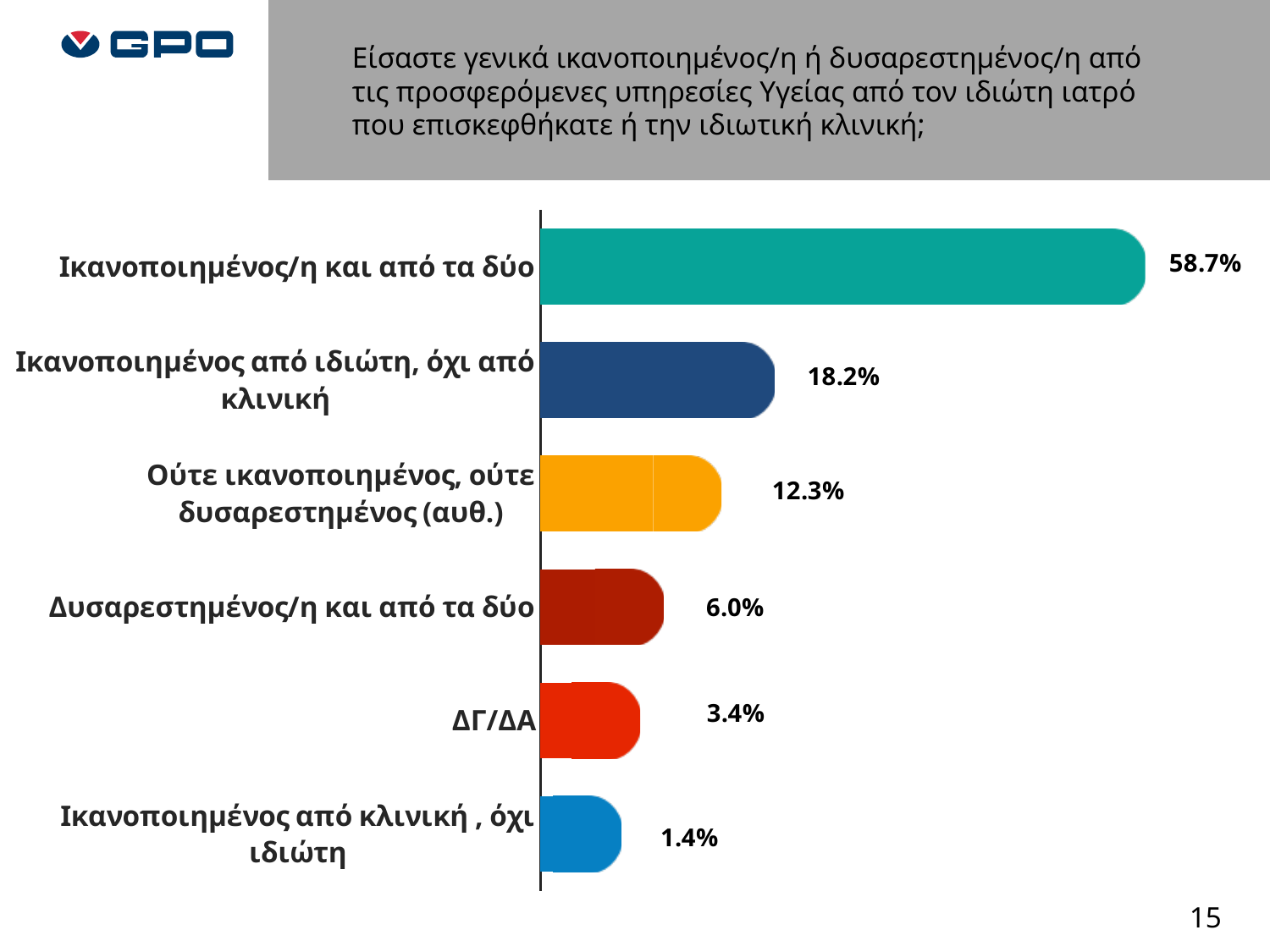
Which category has the highest value? Ικανοποιημένος/η και από τα δύο How many categories are shown in the chart? 6 What is the value for "Ικανοποιημένος από ιδιώτη, όχι από κλινική"? 18.2% Which is larger: "Ούτε ικανοποιημένος, ούτε δυσαρεστημένος (αυθ.)" or "Δυσαρεστημένος/η και από τα δύο"? Ούτε ικανοποιημένος, ούτε δυσαρεστημένος (αυθ.) What kind of chart is shown on the slide? Bar chart What is the value for "ΔΓ/ΔΑ"? 3.4% What is the value for "Ούτε ικανοποιημένος, ούτε δυσαρεστημένος (αυθ.)"? 12.3% Which category has the lowest value? Ικανοποιημένος από κλινική , όχι ιδιώτη What is the value for "Ικανοποιημένος/η και από τα δύο"? 58.7% What is the difference between "Δυσαρεστημένος/η και από τα δύο" and "ΔΓ/ΔΑ"? 2.6% What is the difference between "Ικανοποιημένος/η και από τα δύο" and "Ικανοποιημένος από ιδιώτη, όχι από κλινική"? 40.5% What colour is the bar for "Ικανοποιημένος/η και από τα δύο"? Teal